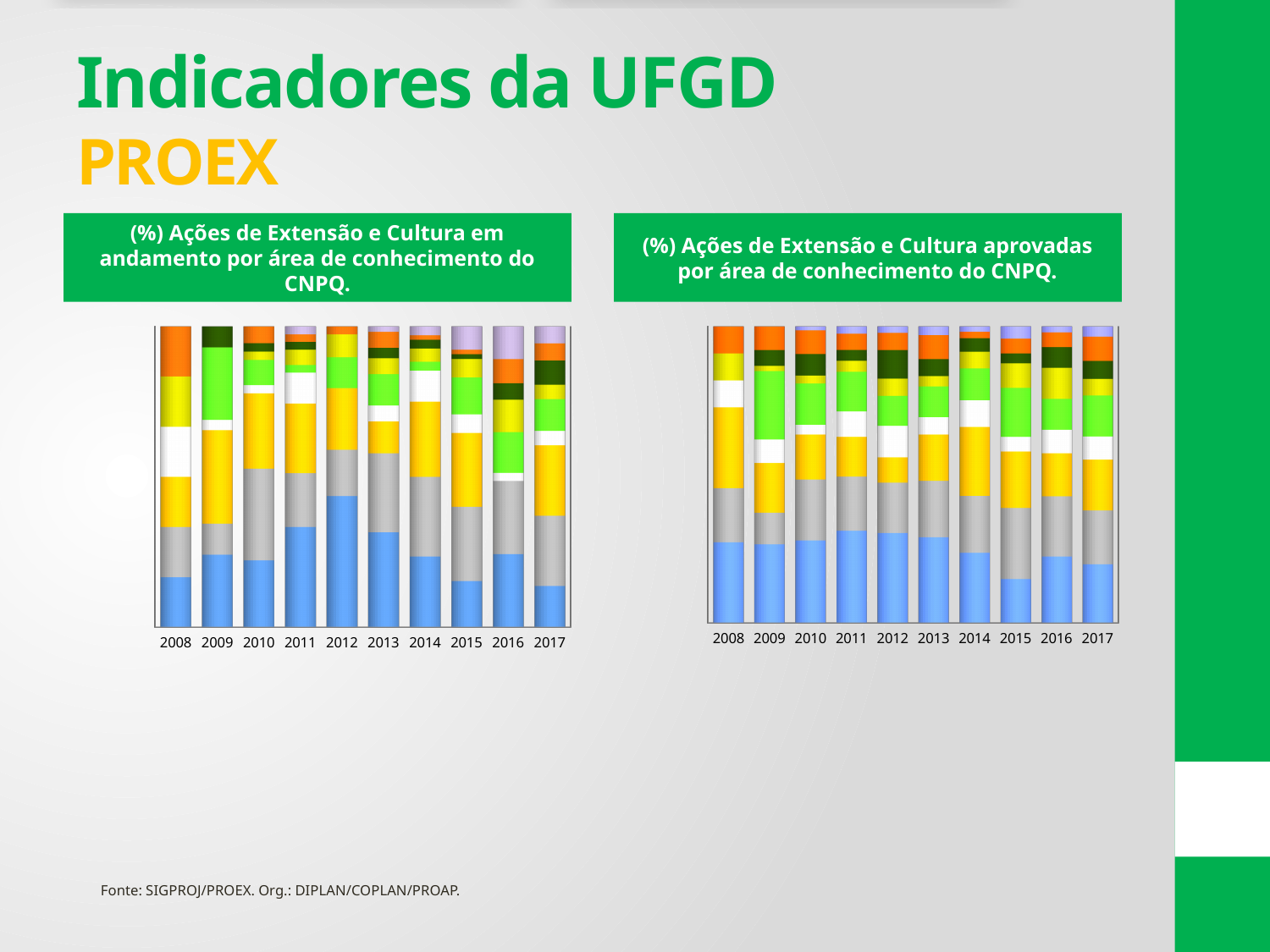
In the left chart, which year has the largest orange segment? 2008 What is the title of the right chart? (%) Ações de Extensão e Cultura aprovadas por área de conhecimento do CNPQ. In the right chart, what is the last year shown on the x axis? 2017 In the left chart, is the blue (bottom) segment larger in 2012 or in 2008? 2012 What kind of chart is the left chart, '(%) Ações de Extensão e Cultura em andamento por área de conhecimento do CNPQ.'? Stacked bar chart In the left chart, what is the first year shown on the x axis? 2008 What kind of chart is the right chart, '(%) Ações de Extensão e Cultura aprovadas por área de conhecimento do CNPQ.'? Stacked bar chart In the right chart, which year has the smallest blue (bottom) segment? 2015 In the left chart, which year has the largest blue (bottom) segment? 2012 In the left chart, how many years are shown on the x axis? 10 In the right chart, is the blue (bottom) segment larger in 2008 or in 2015? 2008 In the right chart, how many bars are plotted? 10